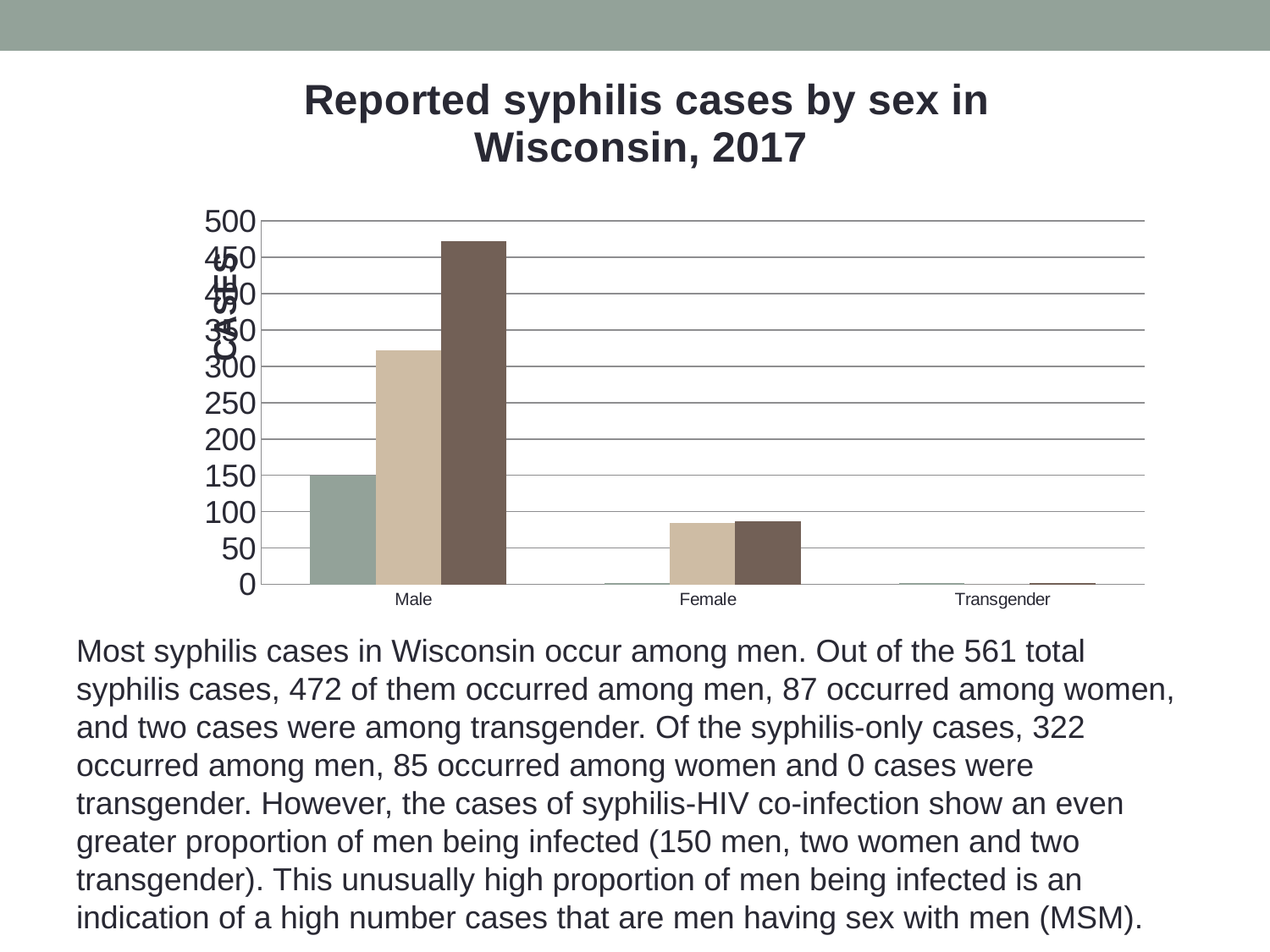
How many categories are shown on the x axis of the chart? 3 What is the title of the chart? Reported syphilis cases by sex in Wisconsin, 2017 Is the value of the tallest bar for Male greater or less than 450? greater What is the label on the y axis of the chart? CASES Which category has the lowest bars in the chart? Transgender Is the value of the tan (middle) bar for Male greater or less than 300? greater What value does the green-gray (left) bar for Male reach on the y axis? 150 Which category has the tallest bar in the chart? Male Is the value of the dark brown bar for Female greater or less than 50? greater Which is larger, the dark brown bar for Male or the dark brown bar for Female? Male What kind of chart is shown on the slide? bar chart